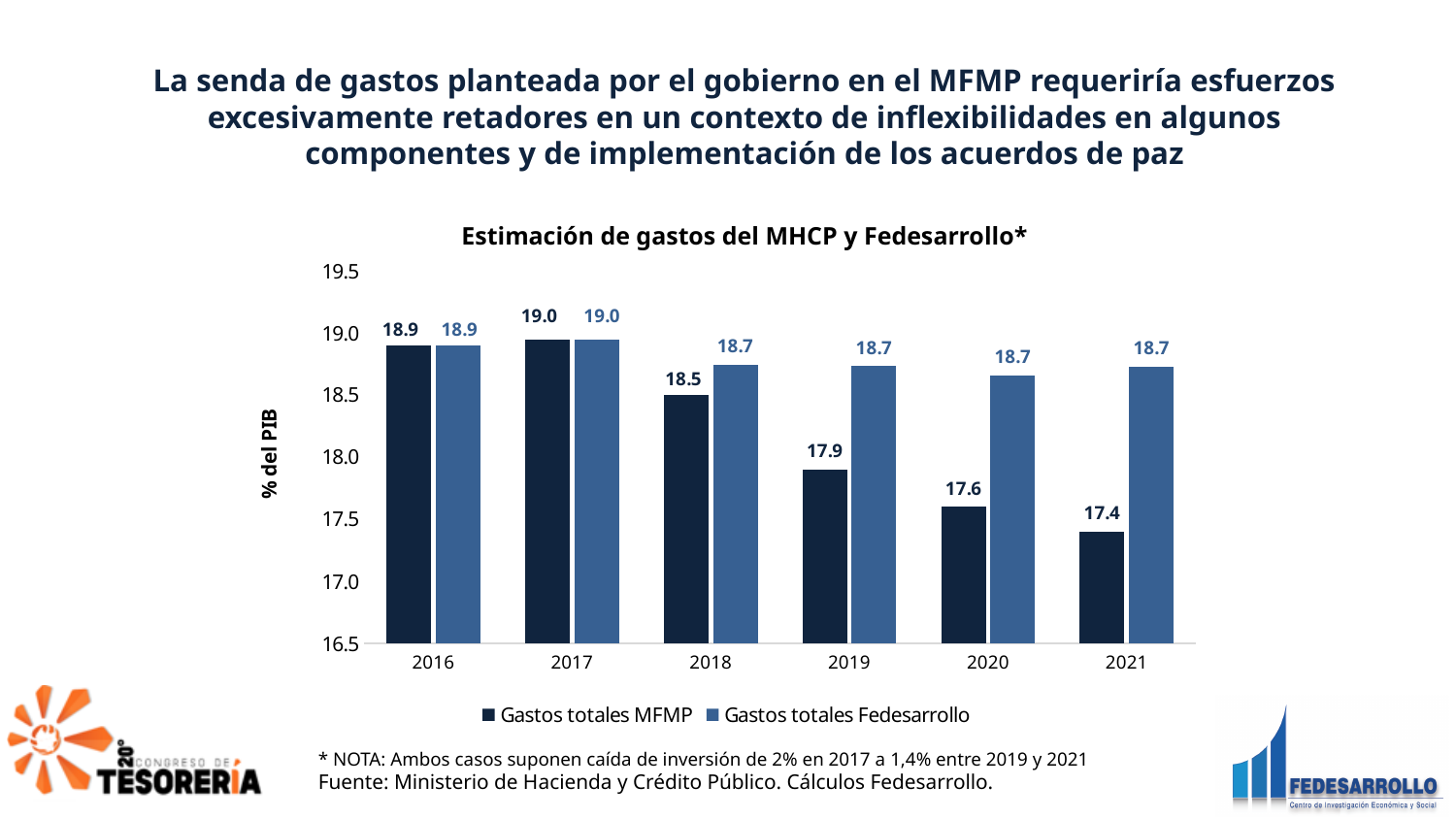
How many years are shown on the x axis? 6 What is the value for Gastos totales MFMP in 2018? 18.5 In 2019, which series has the larger value, Gastos totales MFMP or Gastos totales Fedesarrollo? Gastos totales Fedesarrollo What is the difference between Gastos totales Fedesarrollo and Gastos totales MFMP in 2020? 1.1 Which year has the highest value for Gastos totales MFMP? 2017 What is the value for Gastos totales Fedesarrollo in 2019? 18.7 What is the value for Gastos totales MFMP in 2021? 17.4 What is the title of the chart? Estimación de gastos del MHCP y Fedesarrollo* What kind of chart is shown on the slide? Bar chart Which year has the lowest value for Gastos totales MFMP? 2021 Does the value for Gastos totales MFMP rise or fall from 2017 to 2021? Fall How many series does the legend list? 2